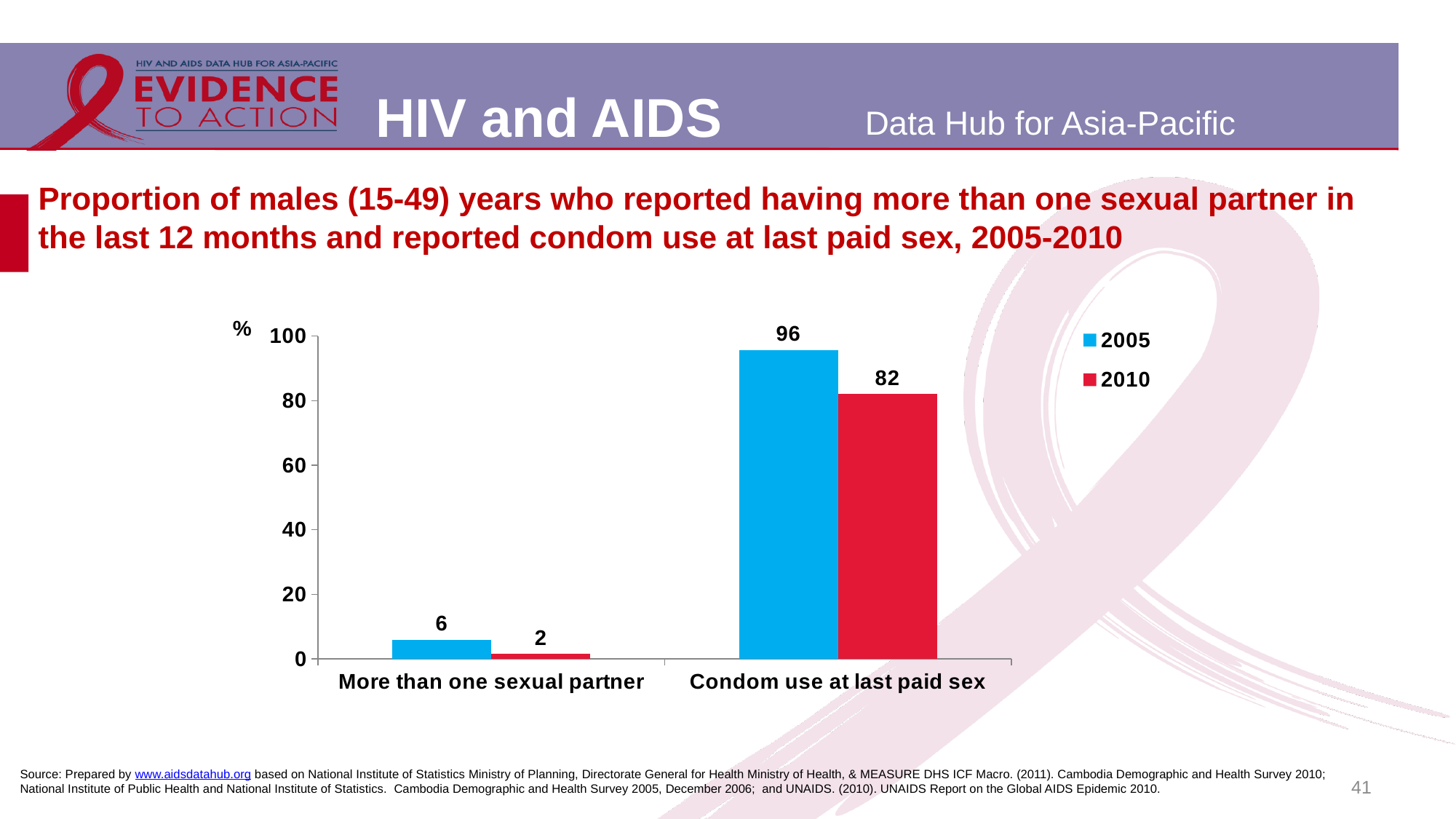
How many categories are shown on the x axis? 2 What kind of chart is shown on the slide? Bar chart What is the difference between the 2005 and 2010 values for 'Condom use at last paid sex'? 14 What is the value for 'Condom use at last paid sex' in 2005? 96 Which category has the highest value in 2005? Condom use at last paid sex What is the value for 'More than one sexual partner' in 2005? 6 What is the difference between the 2005 and 2010 values for 'More than one sexual partner'? 4 What is the value for 'Condom use at last paid sex' in 2010? 82 Which is larger for 'Condom use at last paid sex': the 2005 value or the 2010 value? 2005 What is the value for 'More than one sexual partner' in 2010? 2 Which category has the lowest value in 2010? More than one sexual partner How many series does the legend list? 2